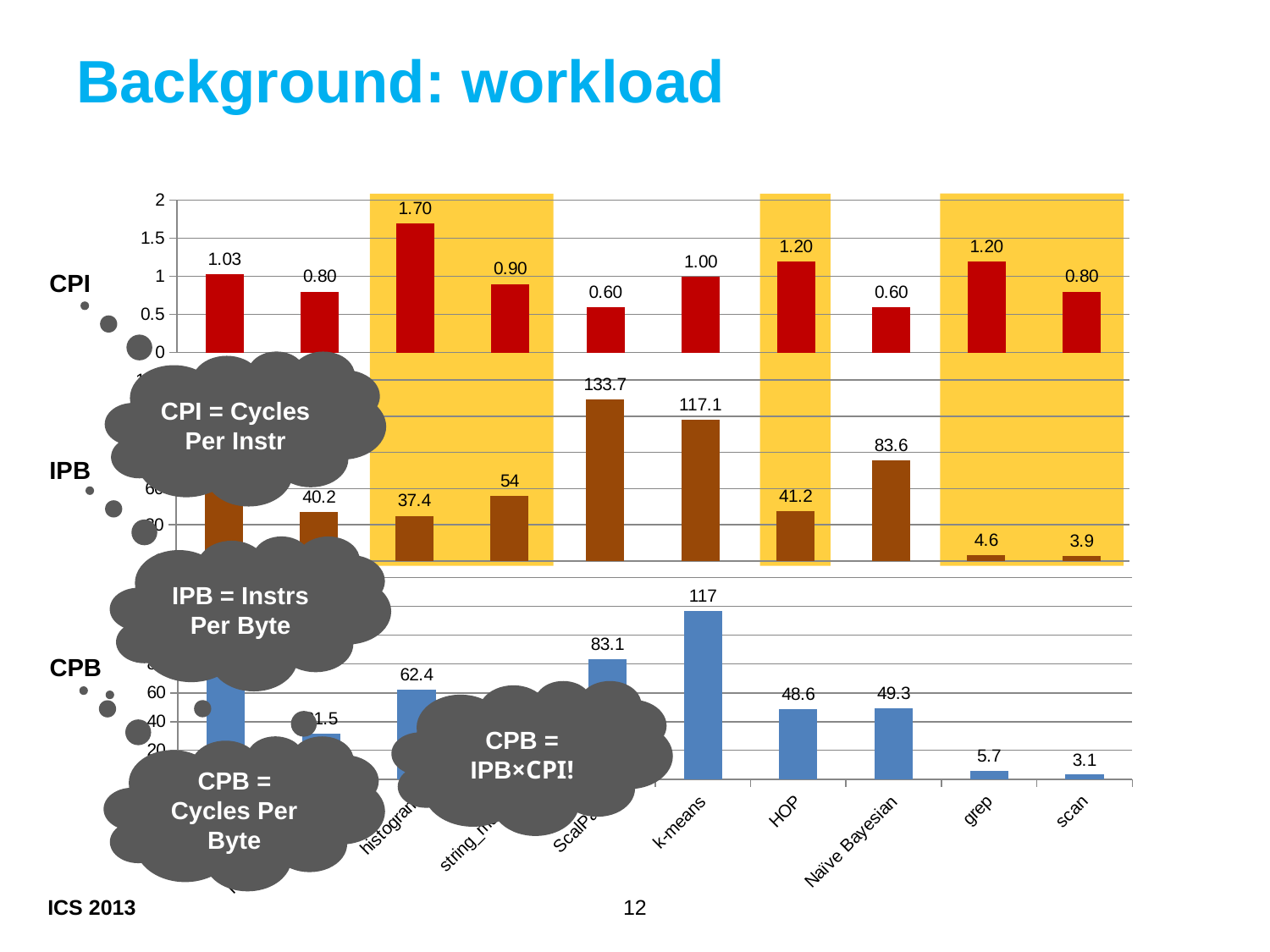
In the CPI chart, which has the larger CPI, HOP or scan? HOP In the CPI chart, what is the highest CPI value shown? 1.70 In the IPB chart, which category has the lowest IPB? scan In the CPB chart, what is the difference between the CPB of Naïve Bayesian and HOP? 0.7 In the IPB chart, what is the IPB value for grep? 4.6 In the IPB chart, what is the IPB value for Naïve Bayesian? 83.6 In the CPI chart, what is the CPI value for k-means? 1.00 In the CPI chart, what is the CPI value for HOP? 1.20 In the IPB chart, what is the difference between the IPB of k-means and HOP? 75.9 In the CPB chart, what is the CPB value for k-means? 117 What kind of chart is used for the CPB data? bar chart In the CPB chart, which category has the highest CPB? k-means